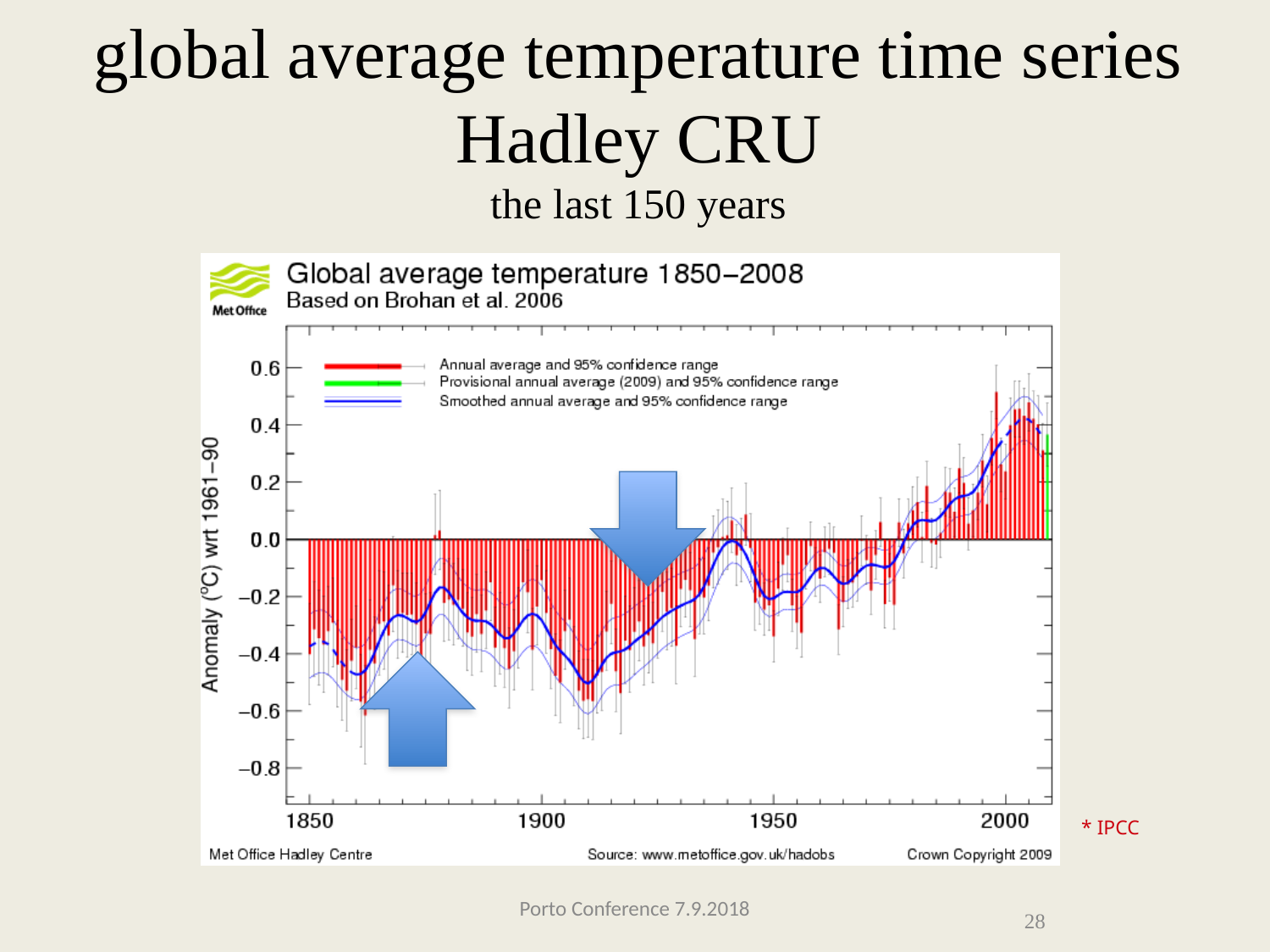
What kind of chart is used to show the annual average temperature anomalies? Bar chart (with a smoothed line overlaid) Is the annual average anomaly around 1910 greater or less than -0.2? less What is the label on the vertical axis of the chart? Anomaly (°C) wrt 1961–90 What is the title printed on the chart? Global average temperature 1850–2008 Is the annual average anomaly for 1998 greater or less than 0.2? greater Which year has the lower annual average anomaly, 1860 or 1990? 1860 Which year has the larger annual average anomaly, 1900 or 2000? 2000 How many entries does the chart's legend list? 3 Is the annual average anomaly for 2000 greater or less than 0.2? greater Overall, do the temperature anomaly values rise or fall from 1850 to 2008? Rise What colour is the bar for the provisional 2009 annual average? Green